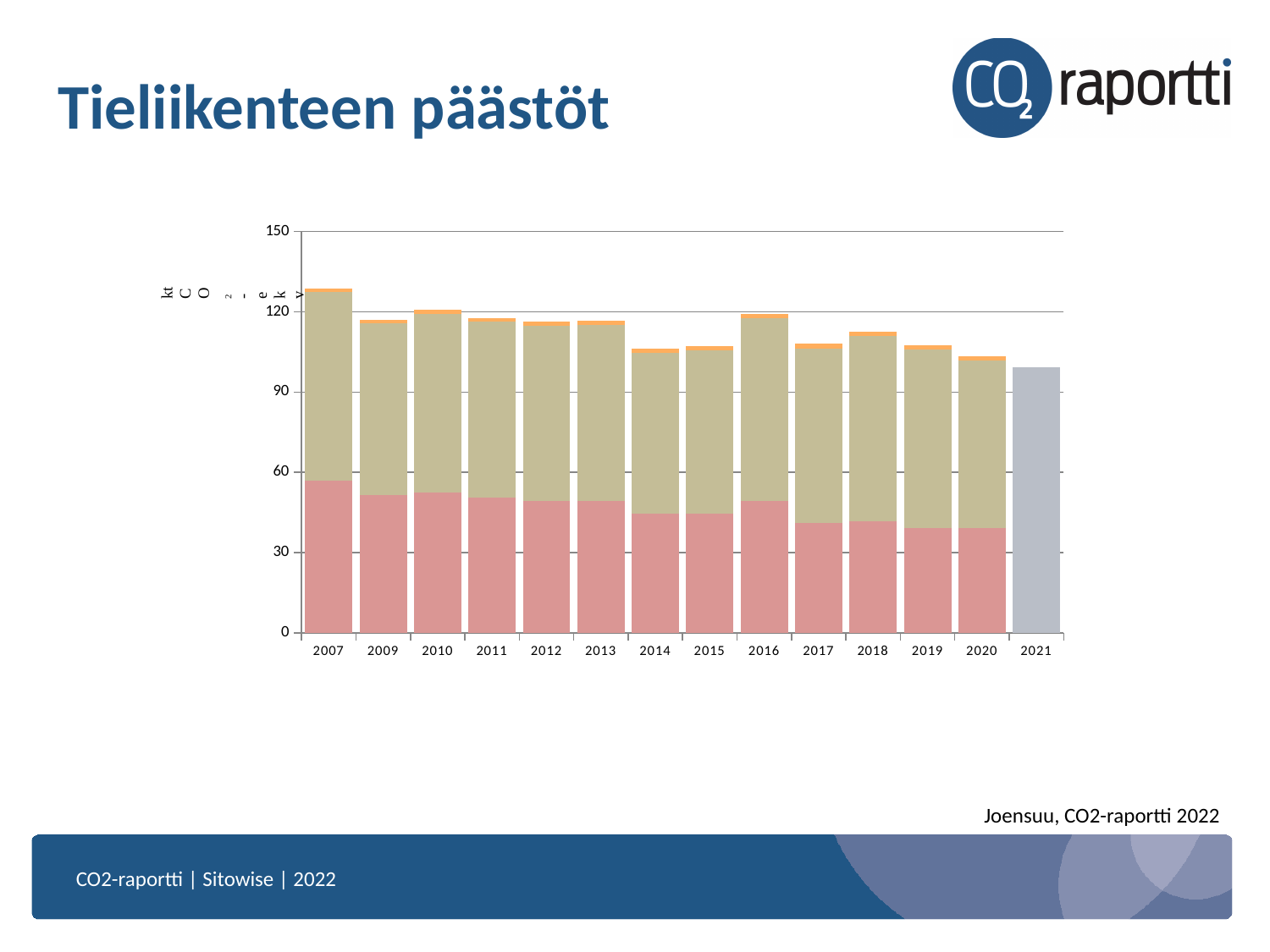
Which year has the taller total bar, 2015 or 2016? 2016 Is the bottom (pink) segment for 2007 greater or less than 60? less Is the total bar height for 2016 greater or less than 90? greater What is the title of the slide containing the chart? Tieliikenteen päästöt Is the total bar height for 2007 greater or less than 120? greater Which year has the taller total bar, 2007 or 2014? 2007 How many years are shown on the x axis of the chart? 14 Which year has the tallest bar in the chart? 2007 What kind of chart is shown on the slide? Stacked bar chart Do the total bar heights generally rise or fall from 2007 to 2021? fall